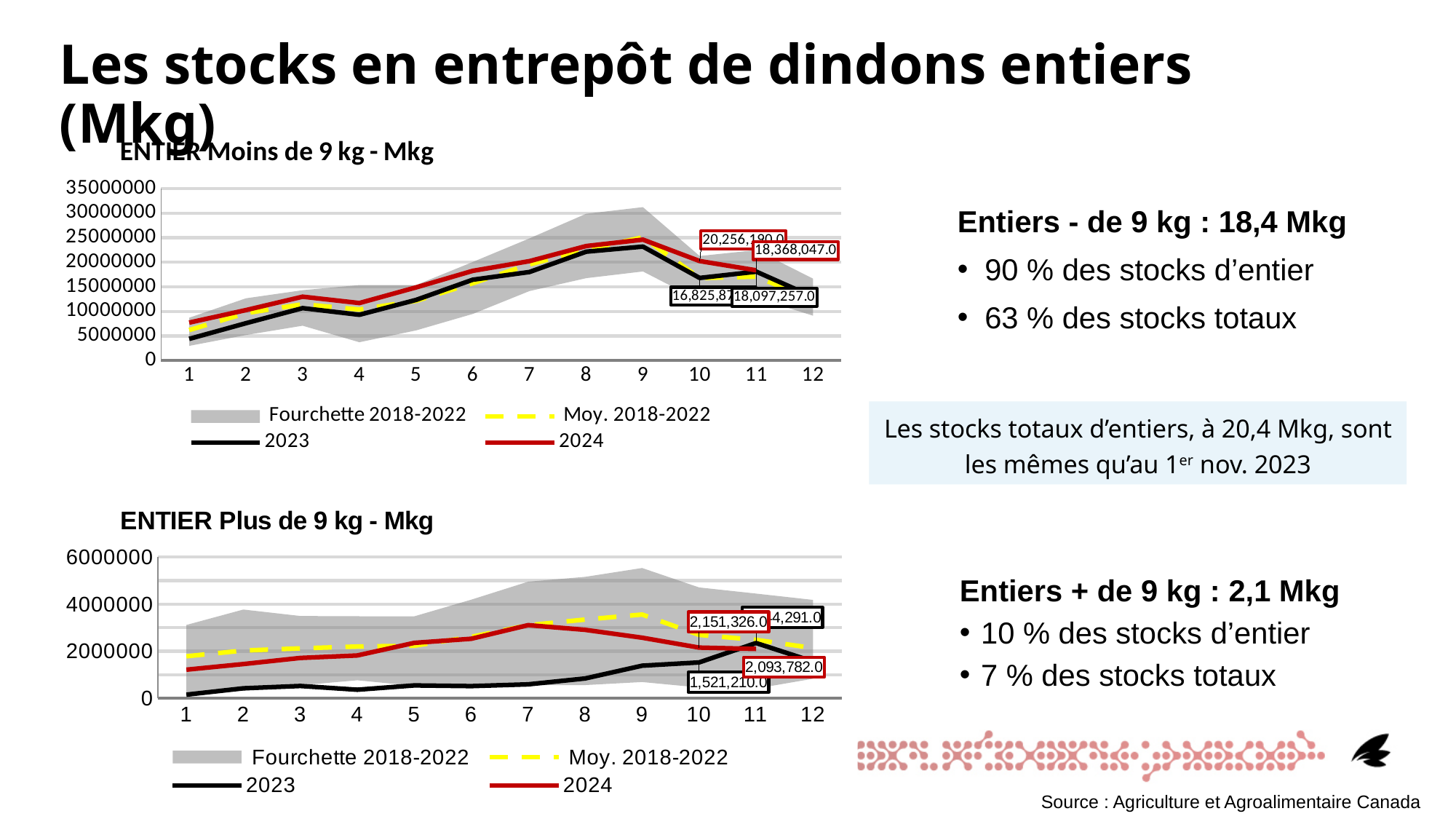
How many points are on the x axis of the 'ENTIER Moins de 9 kg - Mkg' chart? 12 How many series does the legend of the 'ENTIER Plus de 9 kg - Mkg' chart list? 4 In the 'ENTIER Moins de 9 kg - Mkg' chart, what is the labelled 2024 value at month 11? 18,368,047.0 In the 'ENTIER Moins de 9 kg - Mkg' chart, what is the difference between the 2024 and 2023 values at month 11? 270,790.0 In the 'ENTIER Moins de 9 kg - Mkg' chart, at which month does the 2024 line reach its highest value? 9 In the 'ENTIER Plus de 9 kg - Mkg' chart, what is the labelled 2024 value at month 10? 2,151,326.0 In the 'ENTIER Plus de 9 kg - Mkg' chart, what is the labelled 2023 value at month 10? 1,521,210.0 In the 'ENTIER Moins de 9 kg - Mkg' chart, what is the labelled 2023 value at month 11? 18,097,257.0 In the 'ENTIER Moins de 9 kg - Mkg' chart, what is the labelled 2024 value at month 10? 20,256,190.0 In the 'ENTIER Plus de 9 kg - Mkg' chart, what is the difference between the 2024 and 2023 values at month 10? 630,116.0 What kind of chart is the 'ENTIER Moins de 9 kg - Mkg' chart? Line chart In the 'ENTIER Moins de 9 kg - Mkg' chart, is the 2024 value at month 9 greater or less than 20000000? greater